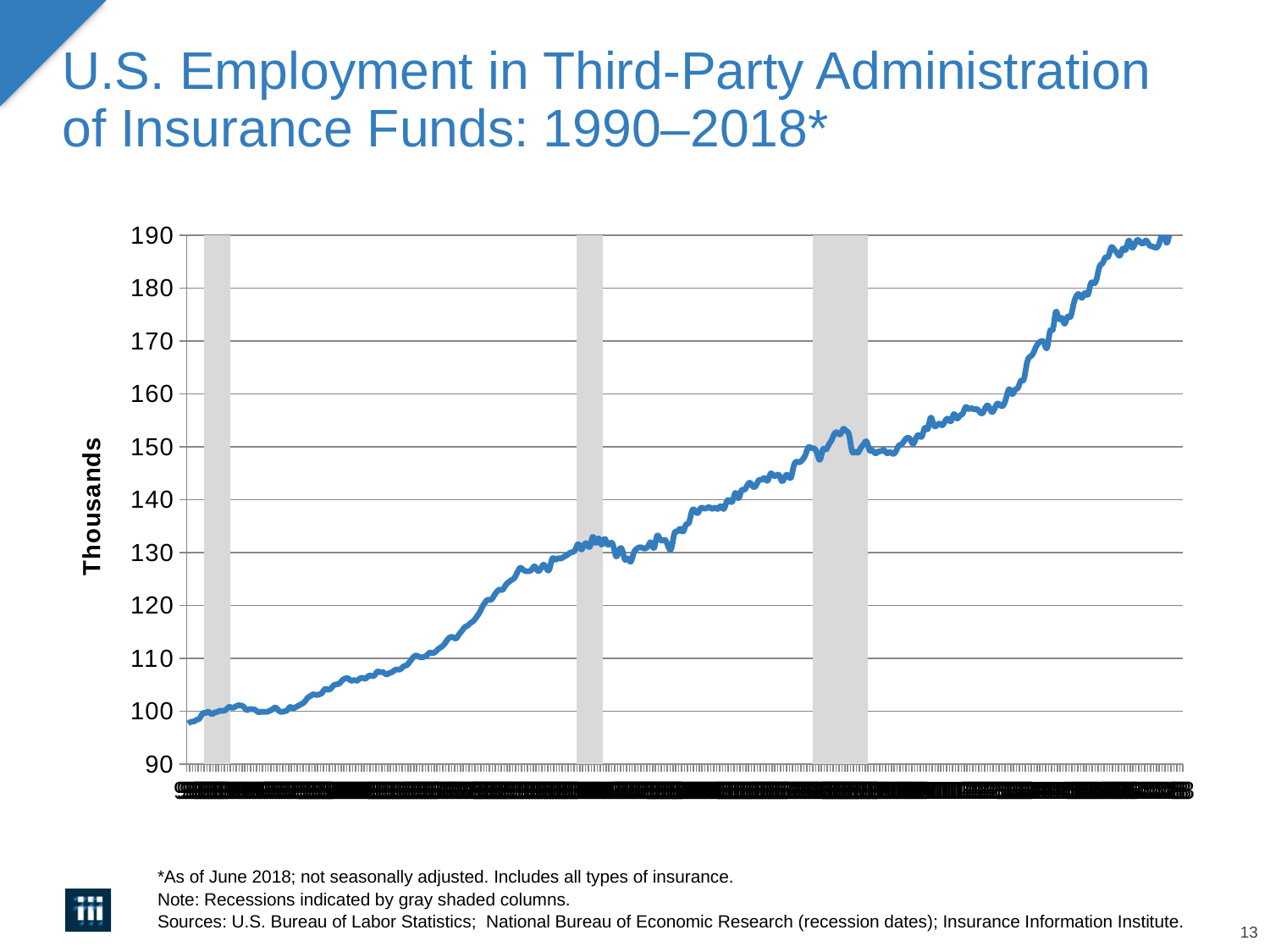
Is the value at the left end of the line greater or less than 120? less How many gray shaded recession columns appear on the chart? 3 Is the highest value reached by the line greater or less than 170? greater How many lines are plotted on the chart? 1 What is the label on the vertical axis? Thousands What is the highest value shown on the vertical axis? 190 What is the title of the chart? U.S. Employment in Third-Party Administration of Insurance Funds: 1990–2018* Do the values generally rise or fall from left to right along the x axis? rise Is the value at the left end of the line greater or less than 110? less Which is larger, the value at the left end of the line or the value at the right end? the right end What kind of chart is shown on the slide? line chart